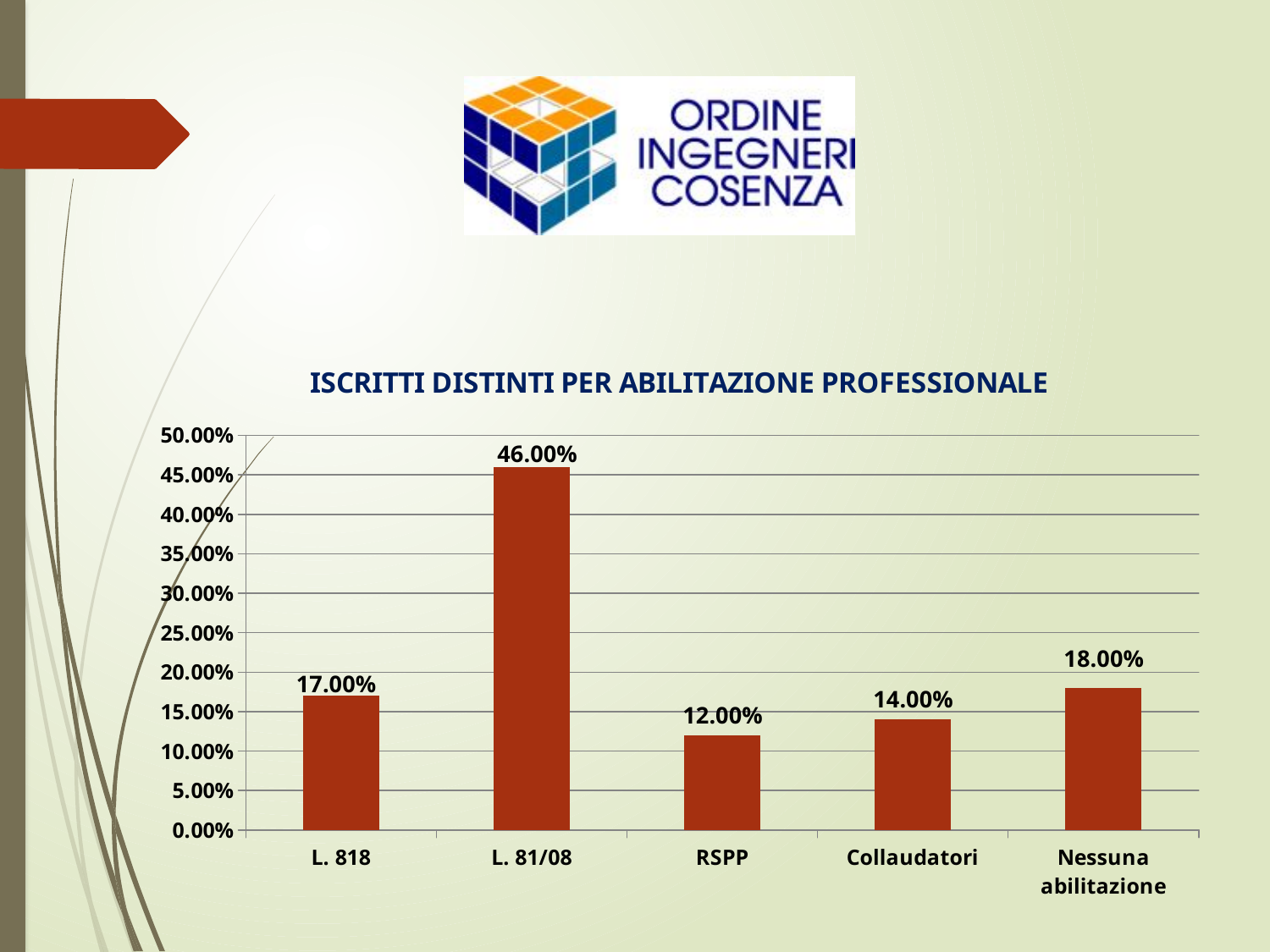
Which category has the lowest value? RSPP How many categories are shown on the x axis? 5 What is the difference between the values for L. 81/08 and L. 818? 29.00% What kind of chart is shown on the slide? bar chart What is the value for RSPP? 12.00% What is the value for Collaudatori? 14.00% Is the value for Collaudatori greater or less than 15.00%? less What is the value for Nessuna abilitazione? 18.00% Which category has the highest value? L. 81/08 What is the title of the chart? ISCRITTI DISTINTI PER ABILITAZIONE PROFESSIONALE Which is larger, the value for Nessuna abilitazione or the value for L. 818? Nessuna abilitazione What is the value for L. 81/08? 46.00%